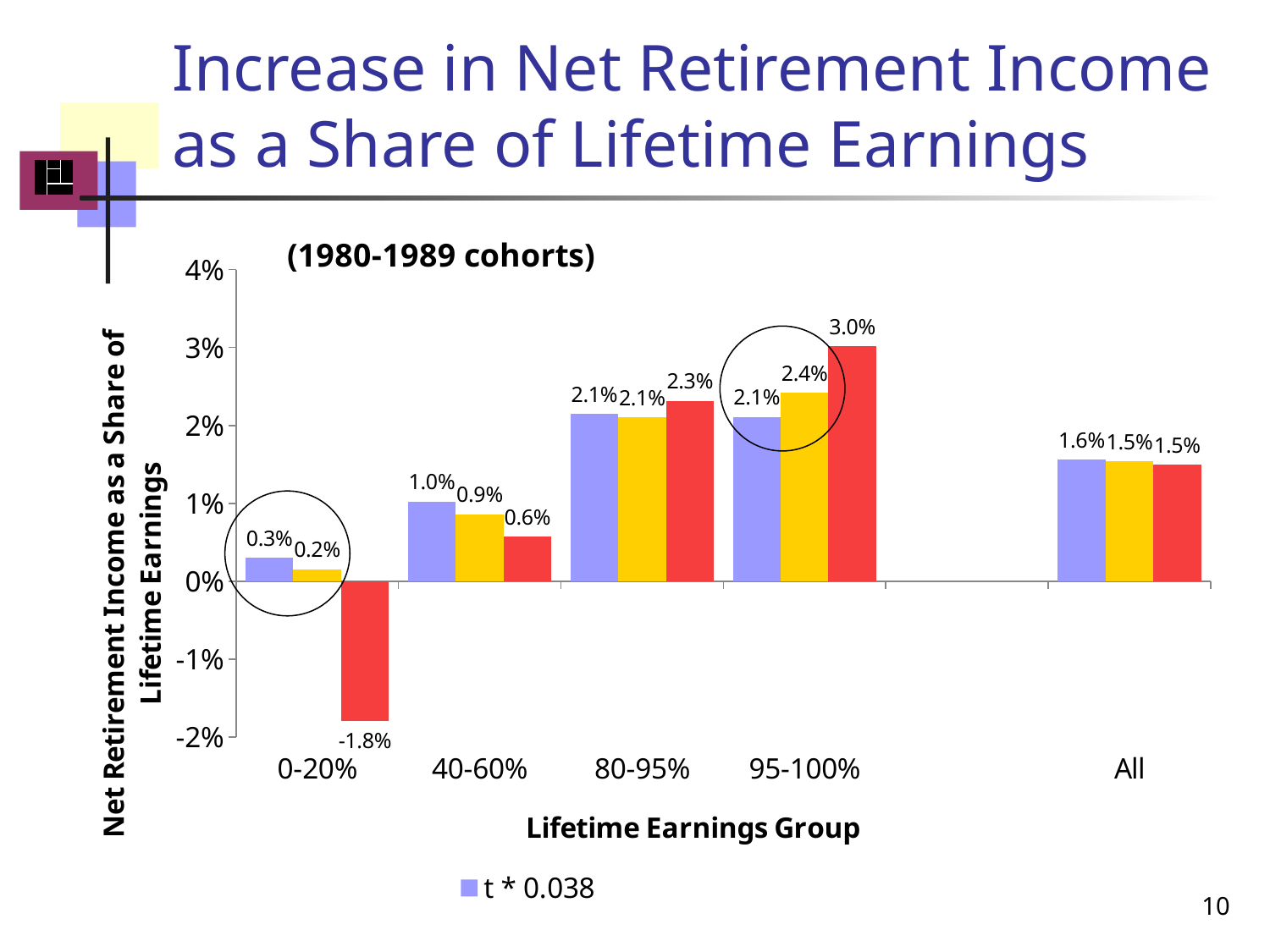
What is the value of the blue bar for the All group? 1.6% What subtitle appears above the chart? (1980-1989 cohorts) What is the value of the yellow bar for the 95-100% lifetime earnings group? 2.4% Is the value of the red bar for the 95-100% group greater or less than 2%? greater Which lifetime earnings group has the highest red bar? 95-100% Which bar has the lowest value on the chart? The red bar for 0-20% (-1.8%) Do the red bars rise or fall from the 0-20% group to the 95-100% group? Rise How many lifetime earnings groups are shown on the x axis? 5 For the 40-60% group, which is larger: the blue bar or the yellow bar? The blue bar (1.0%) What is the value of the red bar for the 0-20% lifetime earnings group? -1.8% What kind of chart is shown on the slide? Bar chart For the 95-100% group, how much larger is the red bar than the blue bar? 0.9 percentage points